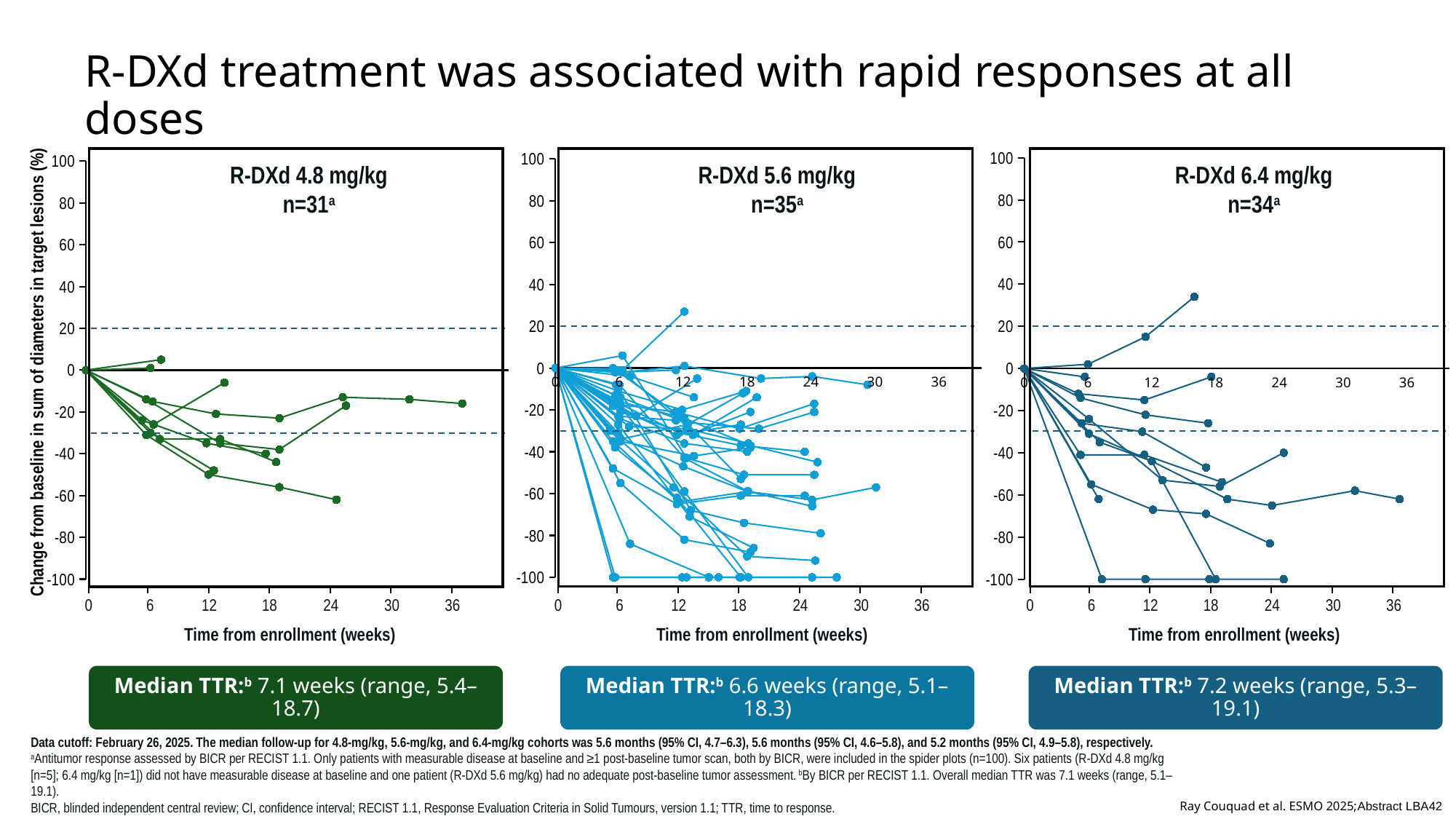
In the R-DXd 4.8 mg/kg chart, is the lowest plotted value greater or less than -40? less In the R-DXd 4.8 mg/kg chart, is the highest plotted value greater or less than 20? less In the R-DXd 6.4 mg/kg chart, is the highest plotted value greater or less than 20? greater What is the n value shown in the title of the R-DXd 6.4 mg/kg chart? n=34 What is the y-axis label of the charts? Change from baseline in sum of diameters in target lesions (%) Which of the three charts has the largest n? R-DXd 5.6 mg/kg How many charts are shown on the slide? 3 What type of chart is the R-DXd 4.8 mg/kg chart? line chart What is the x-axis label of the charts? Time from enrollment (weeks) In the R-DXd 4.8 mg/kg chart, do most of the patient lines rise or fall from baseline over time? fall What is the n value shown in the title of the R-DXd 5.6 mg/kg chart? n=35 Which dose cohort has the shortest median TTR shown below the charts? R-DXd 5.6 mg/kg (6.6 weeks)